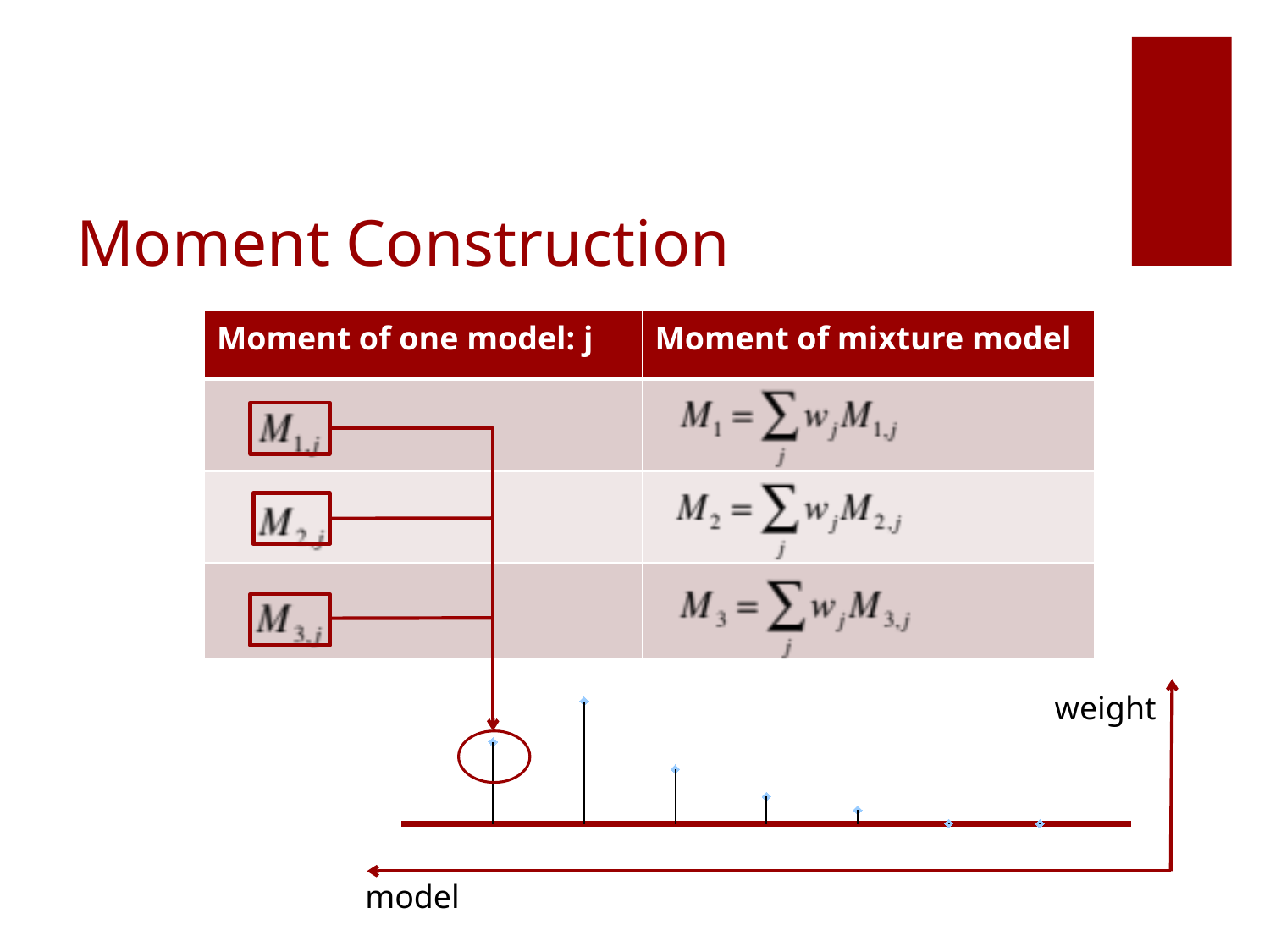
In the weight chart, which has the larger weight: the first model from the left or the third model from the left? the first How many models (points) are plotted along the horizontal axis of the weight chart? 7 In the weight chart, which has the larger weight: the first model from the left or the second model from the left? the second Which model, counting from the left, has the highest weight in the chart? the second What is the label on the horizontal axis of the chart at the bottom of the slide? model What is the label on the vertical axis of the chart at the bottom of the slide? weight Which model in the weight chart is circled? the first (leftmost) From the second model onward, do the weights rise or fall moving to the right along the horizontal axis? fall